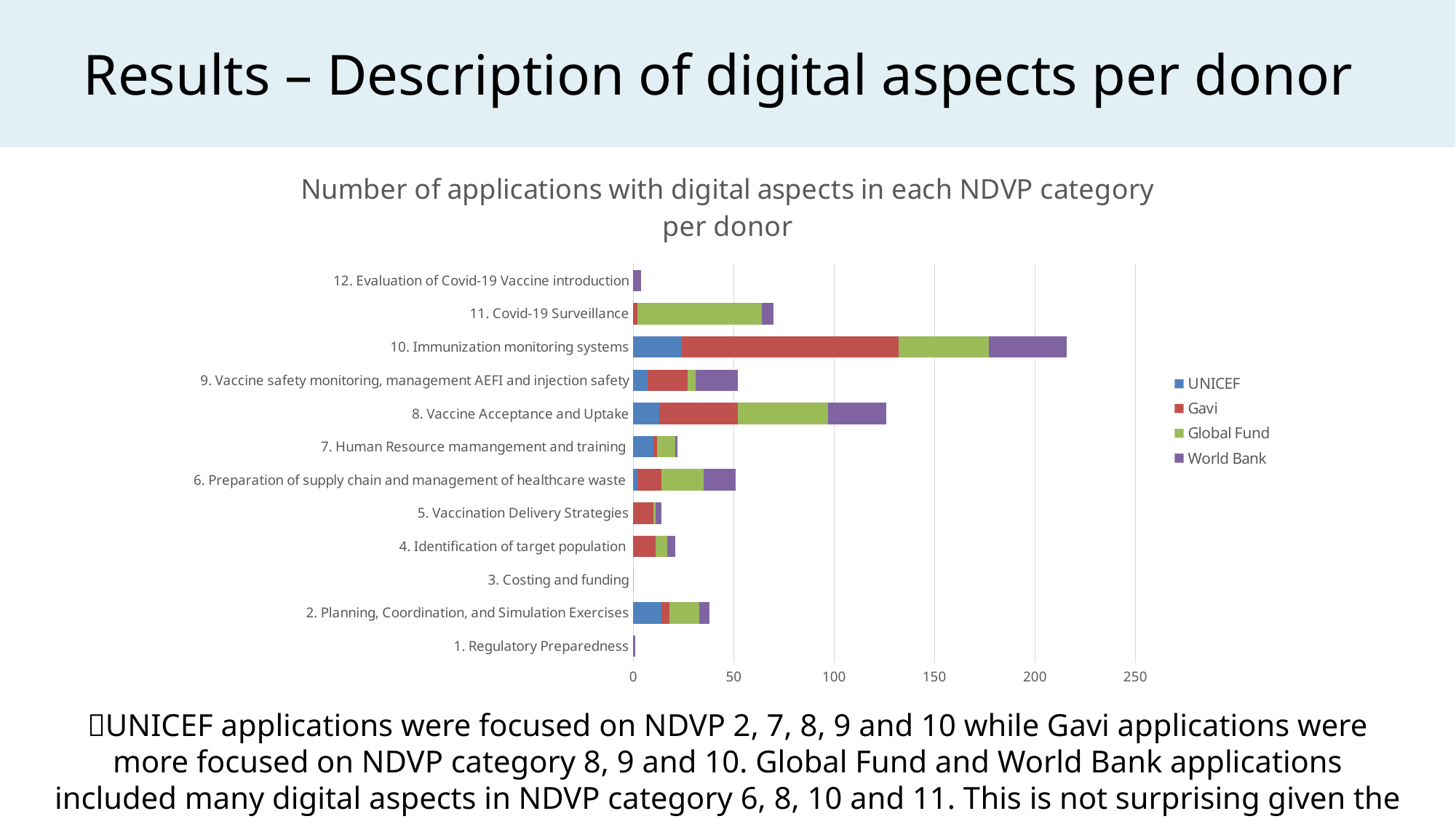
Which NDVP category has the lowest total number of applications with digital aspects? 3. Costing and funding Which has a larger total: '8. Vaccine Acceptance and Uptake' or '9. Vaccine safety monitoring, management AEFI and injection safety'? 8. Vaccine Acceptance and Uptake What is the title of the chart? Number of applications with digital aspects in each NDVP category per donor How many donors (series) does the legend list? 4 Is the total bar length for '10. Immunization monitoring systems' greater or less than 200? greater Is the total bar length for '2. Planning, Coordination, and Simulation Exercises' greater or less than 50? less Is the total bar length for '11. Covid-19 Surveillance' greater or less than 50? greater Which donor is represented by the red segments in the bars? Gavi How many NDVP categories are listed on the chart's vertical axis? 12 What kind of chart is shown on the slide? Stacked bar chart Which NDVP category has the highest total number of applications with digital aspects? 10. Immunization monitoring systems